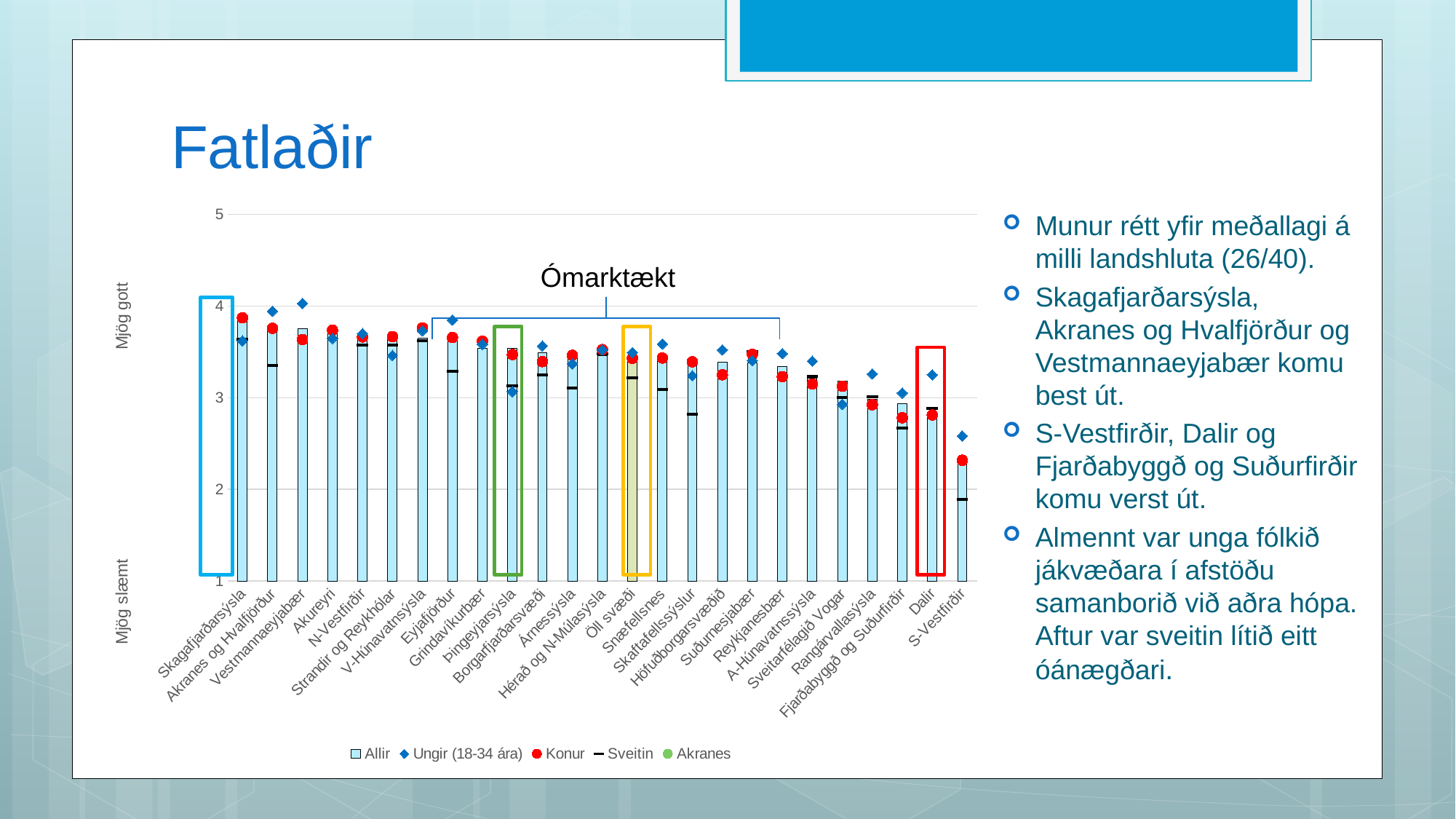
What annotation text is written above the bracket in the middle of the chart? Ómarktækt Do the Allir bar values generally rise or fall from left to right along the x axis? fall What kind of chart is shown on the slide? bar chart Is the Allir value for Dalir greater or less than 3? less Which has the larger Allir value, Skagafjarðarsýsla or S-Vestfirðir? Skagafjarðarsýsla Is the Allir value for S-Vestfirðir greater or less than 3? less Is the Allir value for Skagafjarðarsýsla greater or less than 3? greater How many series does the chart legend list? 5 How many categories are shown along the x axis of the chart? 25 Which series in the legend is shown with a blue diamond marker? Ungir (18-34 ára) Which category has the lowest Allir bar? S-Vestfirðir